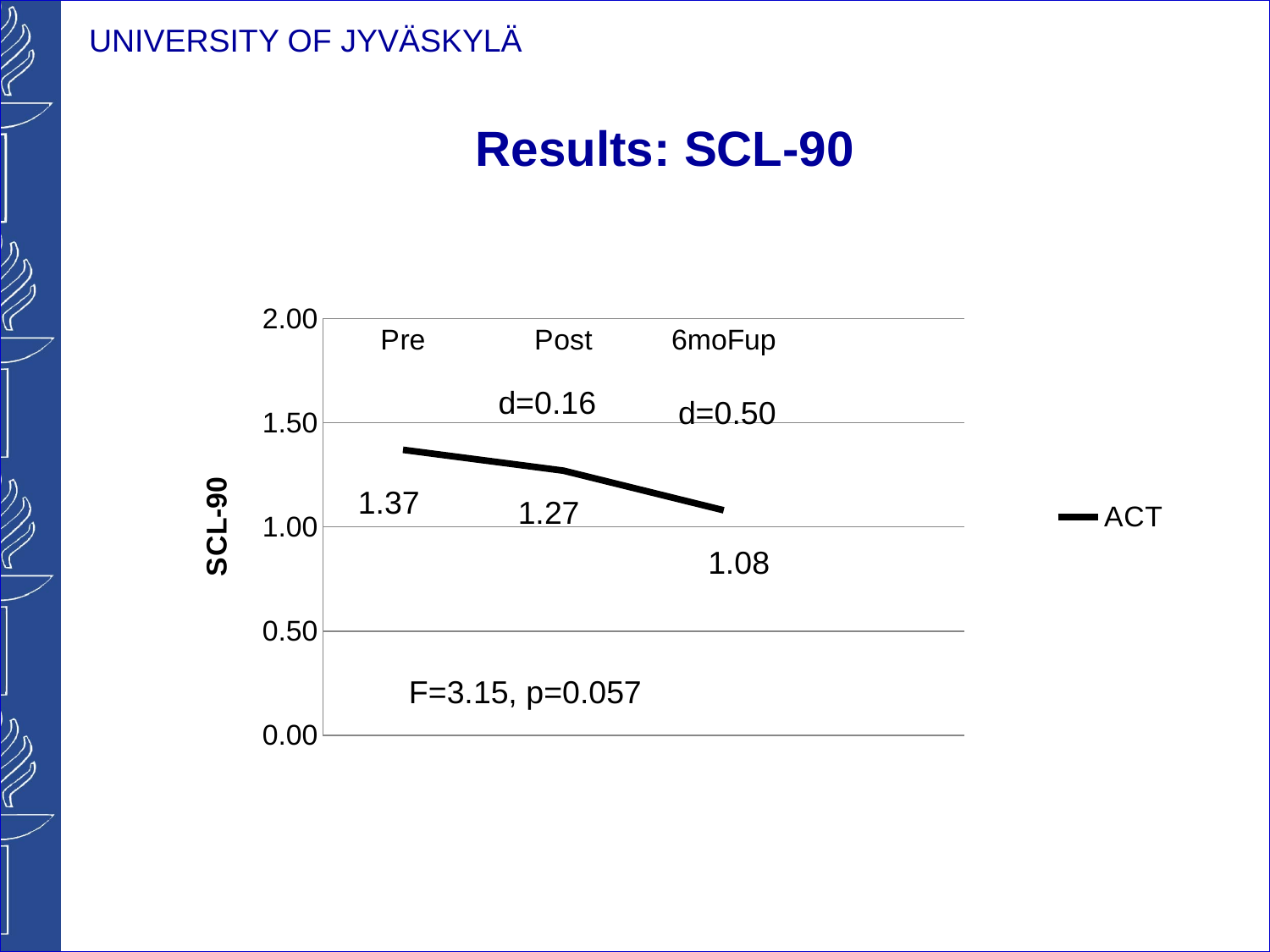
What is the difference between the Pre and Post SCL-90 values? 0.10 Do the SCL-90 values rise or fall from Pre to 6moFup? fall What is the SCL-90 value for ACT at Post? 1.27 Which is larger, the SCL-90 value at Post or at 6moFup? Post How many time points are plotted on the chart? 3 What kind of chart is shown on the slide? line chart What is the difference between the Pre and 6moFup SCL-90 values? 0.29 What is the SCL-90 value for ACT at Pre? 1.37 Is the SCL-90 value at Pre greater or less than 1.50? less What is the SCL-90 value for ACT at 6moFup? 1.08 At which time point is the SCL-90 value highest? Pre At which time point is the SCL-90 value lowest? 6moFup